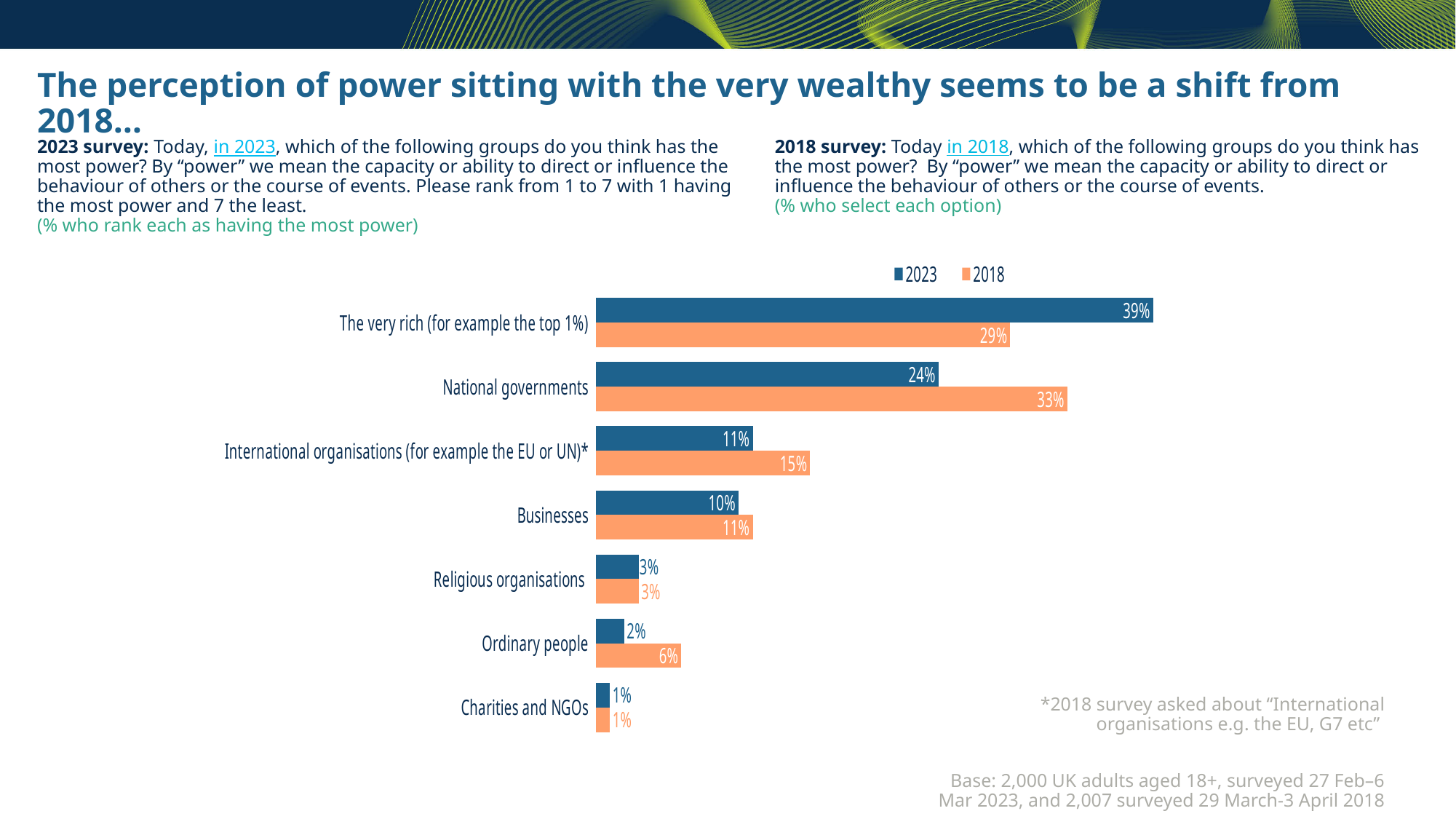
How many groups are shown on the chart? 7 What percentage ranked the very rich as having the most power in 2023? 39% What percentage selected National governments in the 2018 survey? 33% Which group has the highest 2018 value? National governments What type of chart is shown on the slide? Bar chart For International organisations, is the 2023 value or the 2018 value larger? 2018 Which group has the highest 2023 value? The very rich (for example the top 1%) What is the 2023 value for Ordinary people? 2% What is the difference between the 2018 and 2023 values for National governments? 9 percentage points Which group has the lowest value in both 2023 and 2018? Charities and NGOs What is the difference between the 2023 and 2018 values for the very rich? 10 percentage points How many series does the legend list? 2